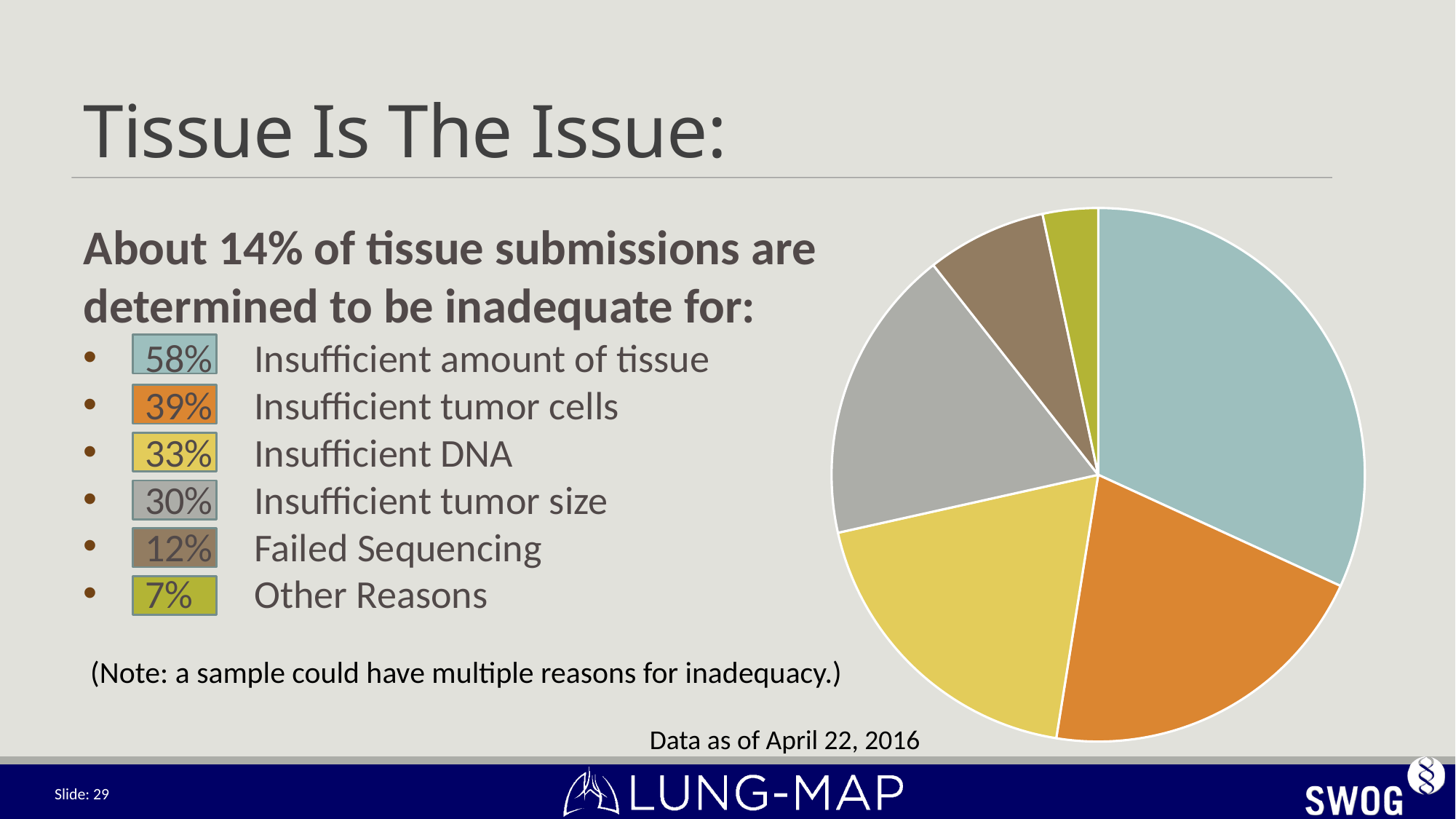
How many reasons for inadequacy are shown in the pie chart? 6 What is the title of the slide containing the pie chart? Tissue Is The Issue: What colour is the slice representing Insufficient tumor cells? orange What percentage is given for Failed Sequencing? 12% What type of chart is shown on the slide? pie chart Which reason for inadequacy has the highest percentage? Insufficient amount of tissue What percentage is given for Insufficient DNA? 33% What percentage is given for Insufficient tumor cells? 39% What is the difference in percentage points between Insufficient amount of tissue and Insufficient tumor cells? 19 Which is larger, the percentage for Insufficient DNA or for Insufficient tumor size? Insufficient DNA What percentage is given for Insufficient amount of tissue? 58% Which reason for inadequacy has the lowest percentage? Other Reasons